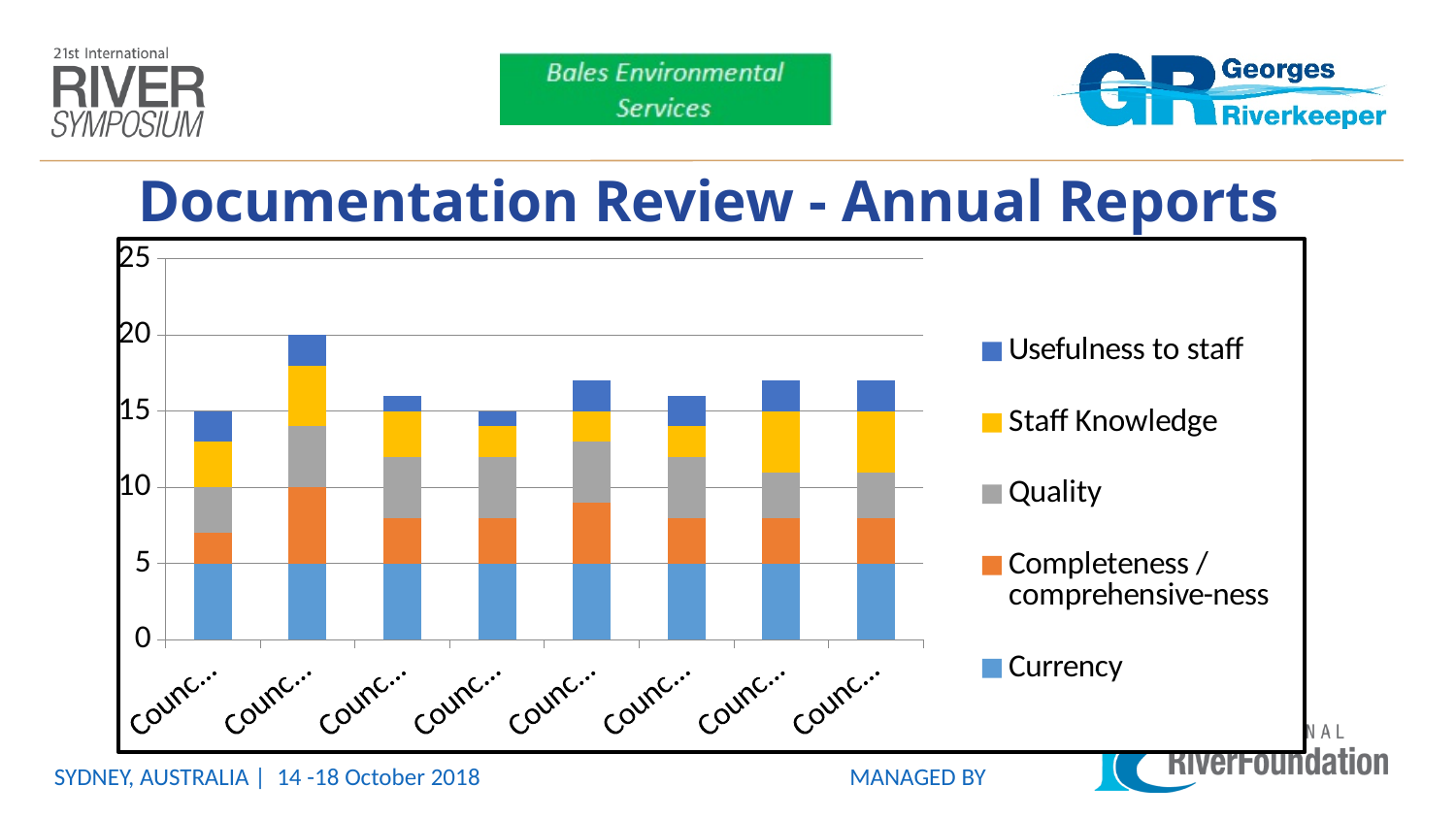
Which bar has the highest total in the chart? The second bar from the left How many series does the chart legend list? 5 Is the total of the fifth bar from the left greater or less than 15? greater What kind of chart is shown on the slide? Stacked bar chart Which series is shown at the bottom of each stacked bar? Currency Which has the larger total, the second bar from the left or the fifth bar from the left? The second bar from the left Is the total of the first bar from the left greater or less than 20? less How many bars (categories) are plotted in the chart? 8 What colour represents the Staff Knowledge series in the chart? Yellow What is the value of the Currency segment in the first bar from the left? 5 What is the total height of the first bar from the left? 15 What is the total height of the second bar from the left? 20